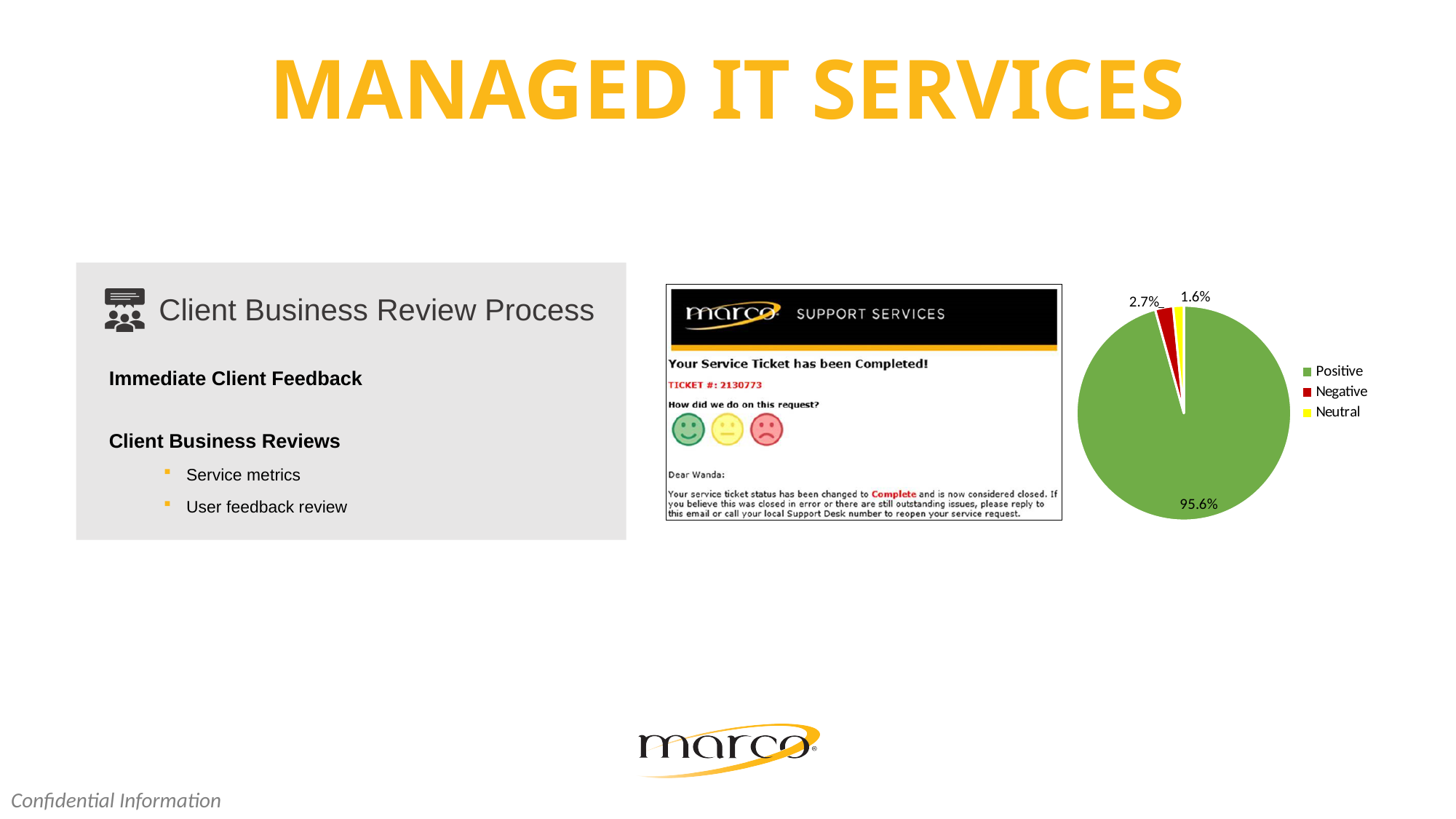
Which category has the largest share of the pie chart? Positive What type of chart is shown on the slide? Pie chart Which slice is larger, Negative or Neutral? Negative Which category is shown in red in the pie chart legend? Negative Which category has the smallest share of the pie chart? Neutral What is the difference in percentage points between the Positive and Negative slices? 92.9 What percentage of the pie chart is Positive? 95.6% How many categories does the pie chart show? 3 What colour is the Positive slice in the pie chart? Green What percentage of the pie chart is Negative? 2.7% What is the difference in percentage points between the Negative and Neutral slices? 1.1 What percentage of the pie chart is Neutral? 1.6%